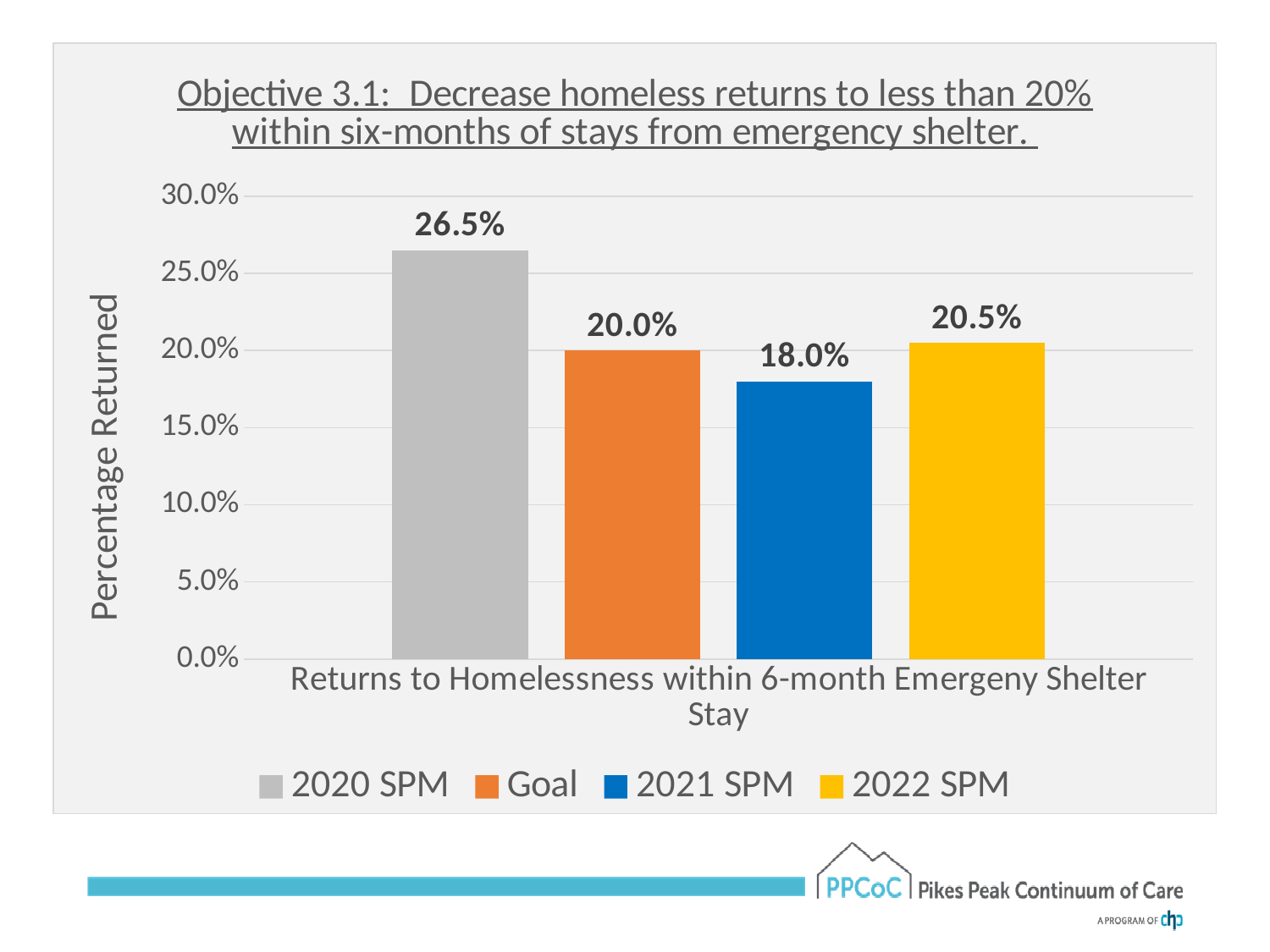
What is the value for 2022 SPM? 20.5% What is the value for 2021 SPM? 18.0% Which series has the highest value? 2020 SPM Which is larger, the 2020 SPM value or the 2022 SPM value? 2020 SPM How many series does the legend list? 4 What is the difference between the 2020 SPM and 2021 SPM values? 8.5% What is the label on the vertical axis? Percentage Returned Which series has the lowest value? 2021 SPM What kind of chart is shown on the slide? Bar chart What is the value of the Goal bar? 20.0% What is the difference between the 2022 SPM value and the Goal? 0.5% What is the value for 2020 SPM? 26.5%